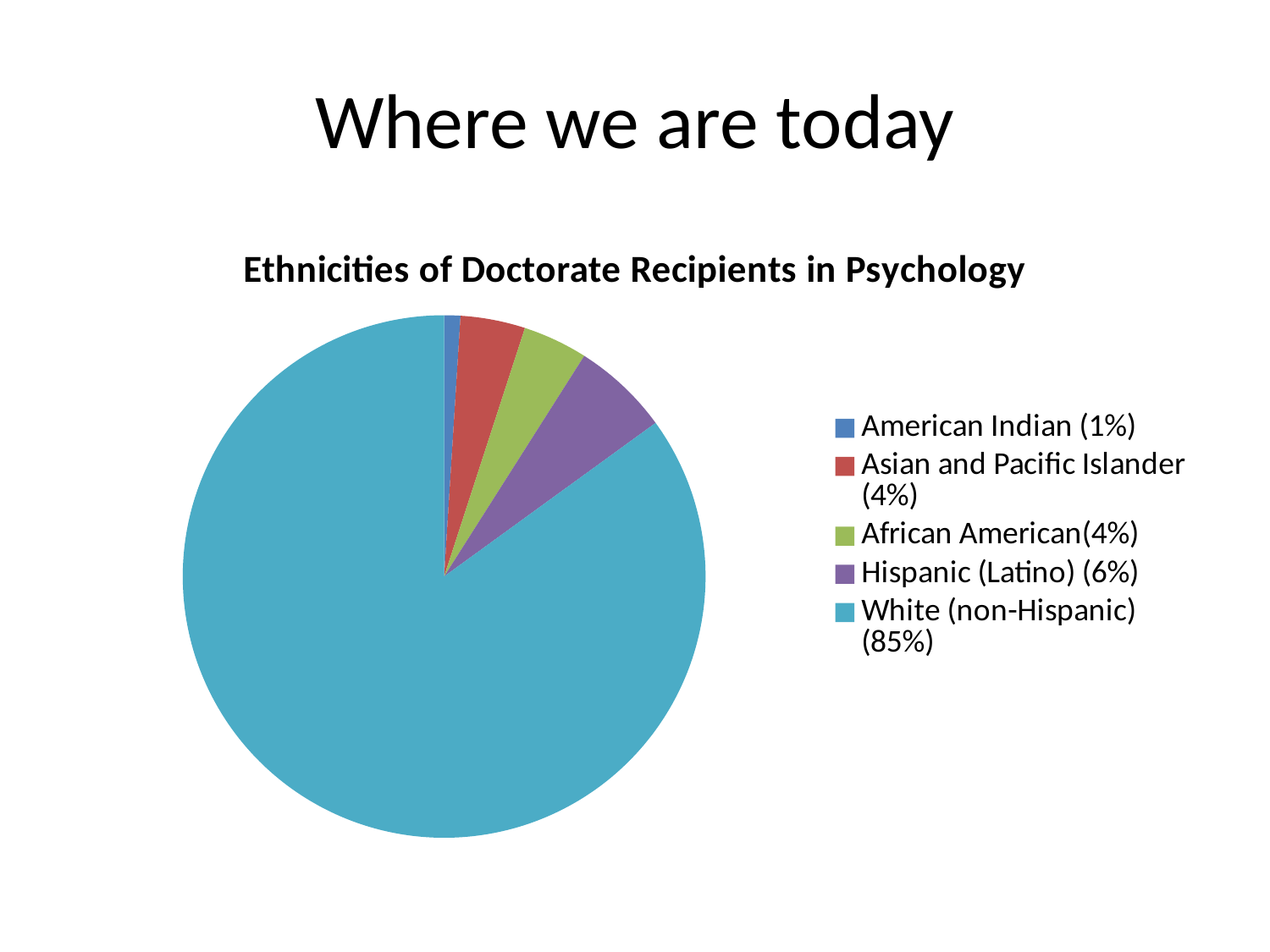
What share of the pie is Asian and Pacific Islander? 4% How many slices does the pie chart have? 5 Which is larger, the Hispanic (Latino) share or the African American share? Hispanic (Latino) What share of the pie is White (non-Hispanic)? 85% What share of the pie is American Indian? 1% What kind of chart is shown on the slide? pie chart Which ethnicity has the smallest slice of the pie? American Indian What is the title of the chart? Ethnicities of Doctorate Recipients in Psychology What is the difference in percentage points between the White (non-Hispanic) share and the Hispanic (Latino) share? 79 Which ethnicity has the largest slice of the pie? White (non-Hispanic) What colour is the slice for Hispanic (Latino)? purple